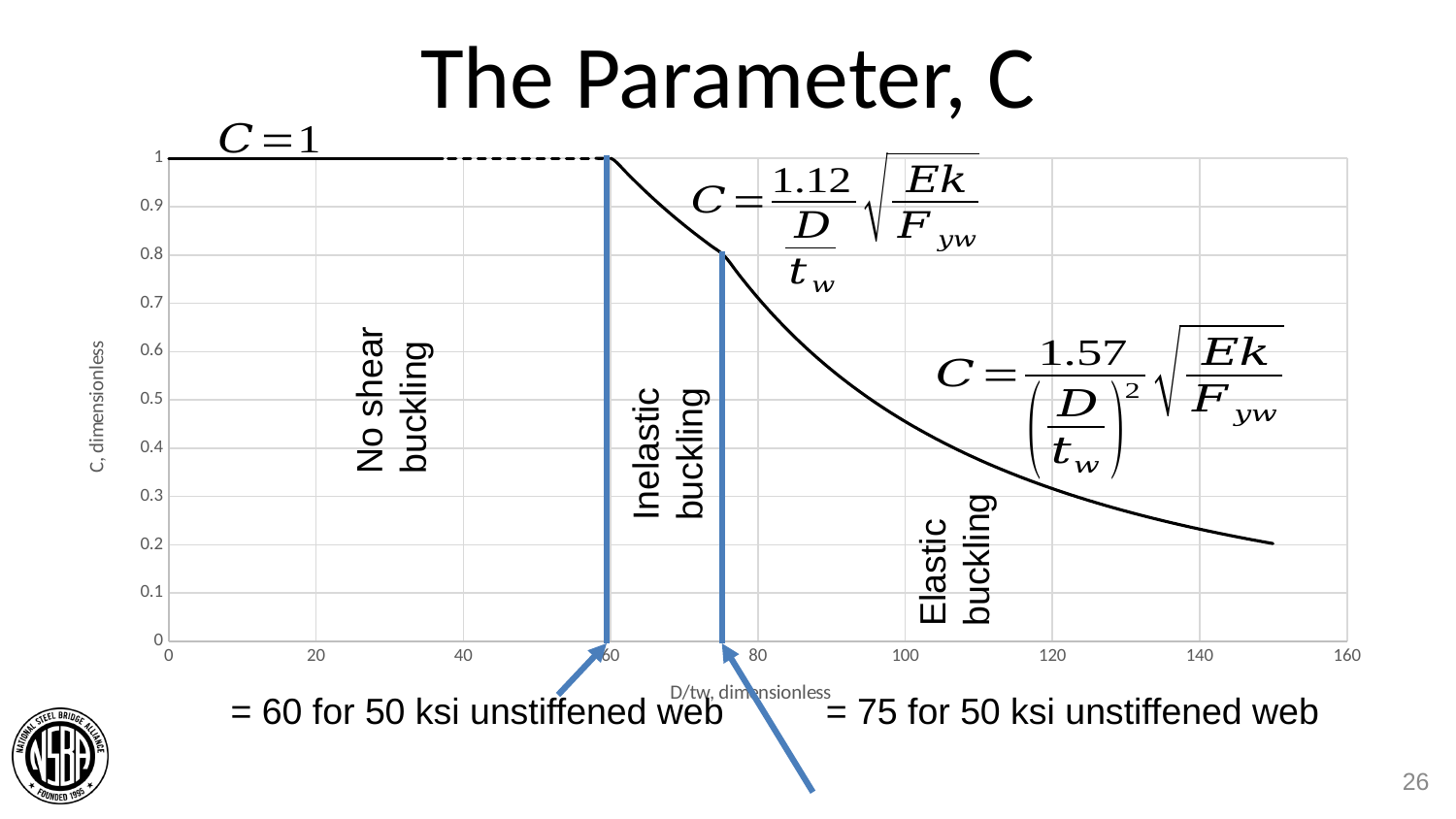
Is the value of C at D/tw = 140 greater or less than 0.3? less What is the title of the chart on the slide? The Parameter, C Does the value of C rise or fall as D/tw increases beyond 60? fall Which is larger, the value of C at D/tw = 60 or at D/tw = 100? D/tw = 60 Is the value of C at D/tw = 40 greater or less than 0.9? greater What is the value of C for D/tw between 0 and 60 on the chart? 1 Is the value of C at D/tw = 100 greater or less than 0.6? less What is the highest value of C reached by the curve on the chart? 1 What is the label of the x axis of the chart? D/tw, dimensionless What kind of chart is shown on the slide? line chart How many buckling regions are labeled on the chart? 3